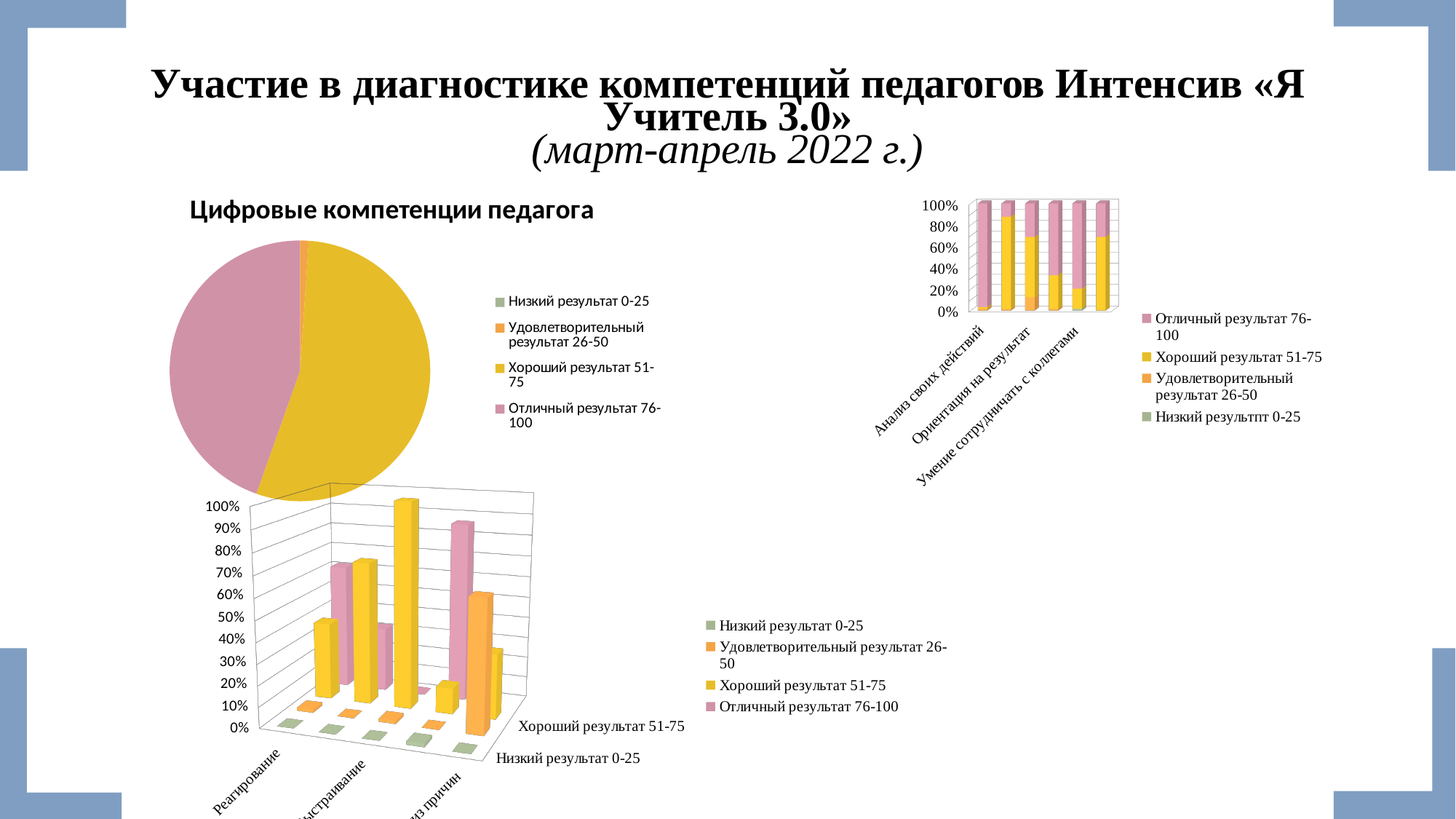
What kind of chart is the chart in the top right of the slide? bar chart How many series does the legend of the top-right chart list? 4 In the bottom-left chart, which series does the tallest bar belong to? Хороший результат 51-75 How many series does the legend of the bottom-left chart list? 4 In the top-right chart, what is the highest value shown on the vertical axis? 100% In the pie chart "Цифровые компетенции педагога", what colour is the slice for "Отличный результат 76-100"? pink In the pie chart "Цифровые компетенции педагога", which slice is larger: "Хороший результат 51-75" or "Отличный результат 76-100"? Хороший результат 51-75 What kind of chart is the chart titled "Цифровые компетенции педагога"? pie chart In the pie chart "Цифровые компетенции педагога", which category has the largest slice? Хороший результат 51-75 In the bottom-left chart, is the tallest bar greater or less than 90%? greater How many entries does the legend of the pie chart "Цифровые компетенции педагога" list? 4 What kind of chart is the chart in the bottom left of the slide? bar chart